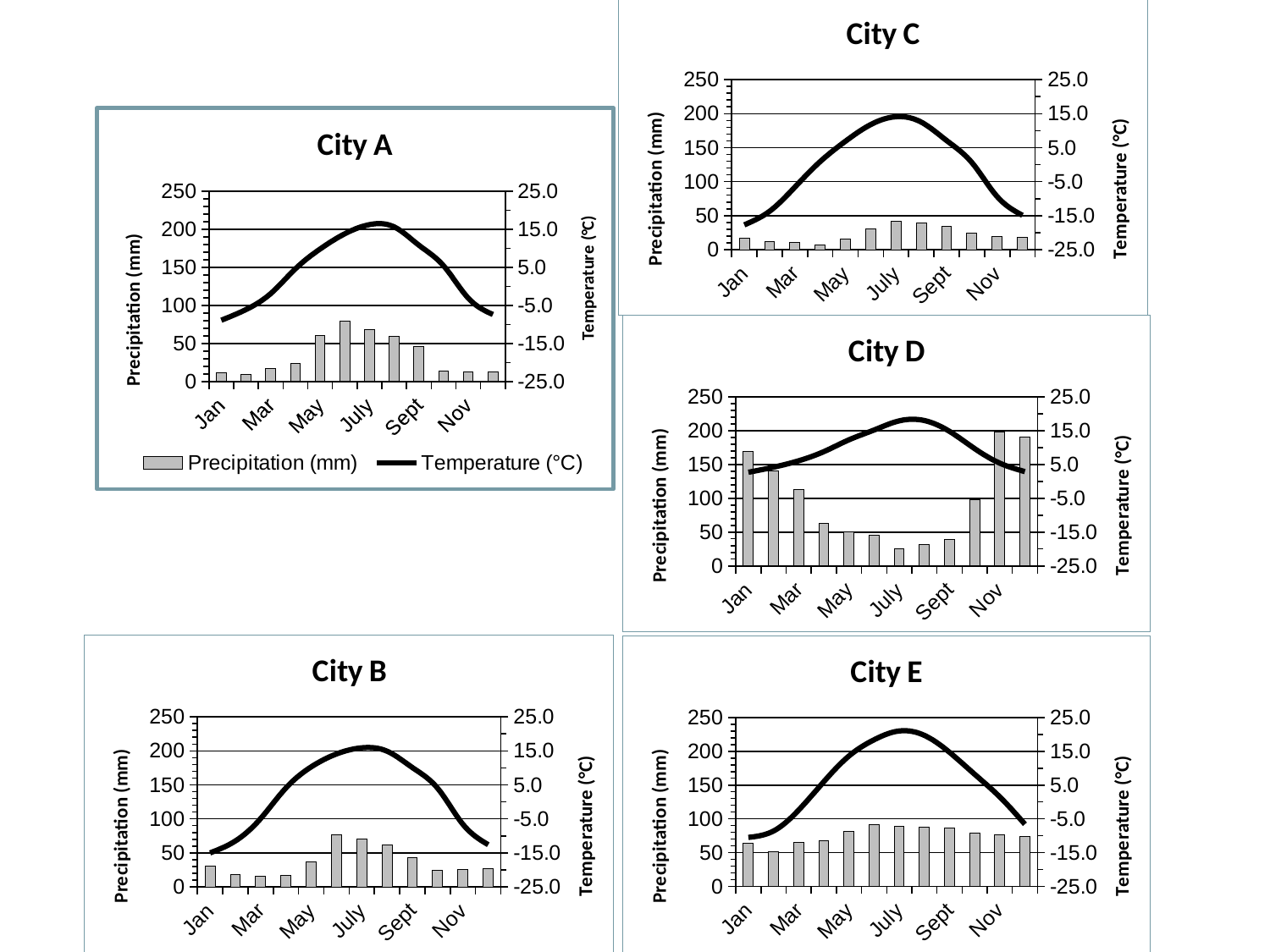
In the City A chart, is the precipitation for Jan greater or less than 50? less What kind of chart is the City A chart? A combined bar and line chart How many precipitation bars are plotted in the City A chart? 12 In the City D chart, which labelled month has the highest precipitation bar? Nov What is the label on the left vertical axis of the City E chart? Precipitation (mm) In the City D chart, which labelled month has the lowest precipitation bar? July How many series does the legend of the City A chart list? 2 In the City A chart, is the precipitation for July greater or less than 50? greater In the City E chart, does temperature rise or fall from Jan to July? rise In the City D chart, does precipitation rise or fall from Jan to July? fall In the City C chart, is the temperature for Jan greater or less than -5.0? less